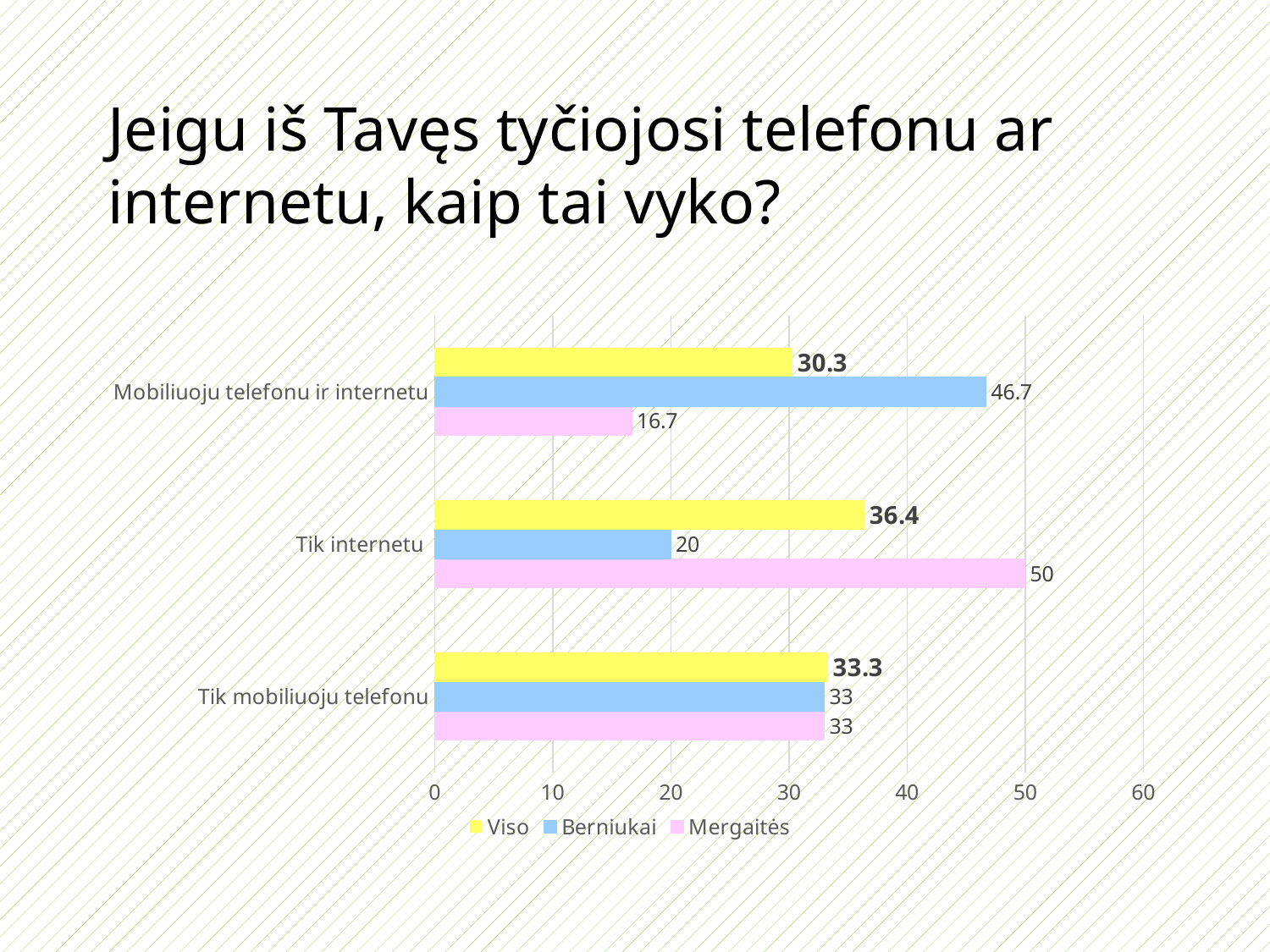
What is the Viso value for Tik internetu? 36.4 What is the Berniukai value for Mobiliuoju telefonu ir internetu? 46.7 What is the Mergaitės value for Tik internetu? 50 Which category has the highest Berniukai value? Mobiliuoju telefonu ir internetu How many series does the legend list? 3 What is the difference between the Berniukai and Mergaitės values for Mobiliuoju telefonu ir internetu? 30 How many categories are shown on the chart? 3 What is the Mergaitės value for Mobiliuoju telefonu ir internetu? 16.7 Which category has the lowest Mergaitės value? Mobiliuoju telefonu ir internetu What is the difference between the Mergaitės and Berniukai values for Tik internetu? 30 What kind of chart is shown on the slide? Bar chart Which is larger for Tik internetu, the Berniukai value or the Mergaitės value? Mergaitės